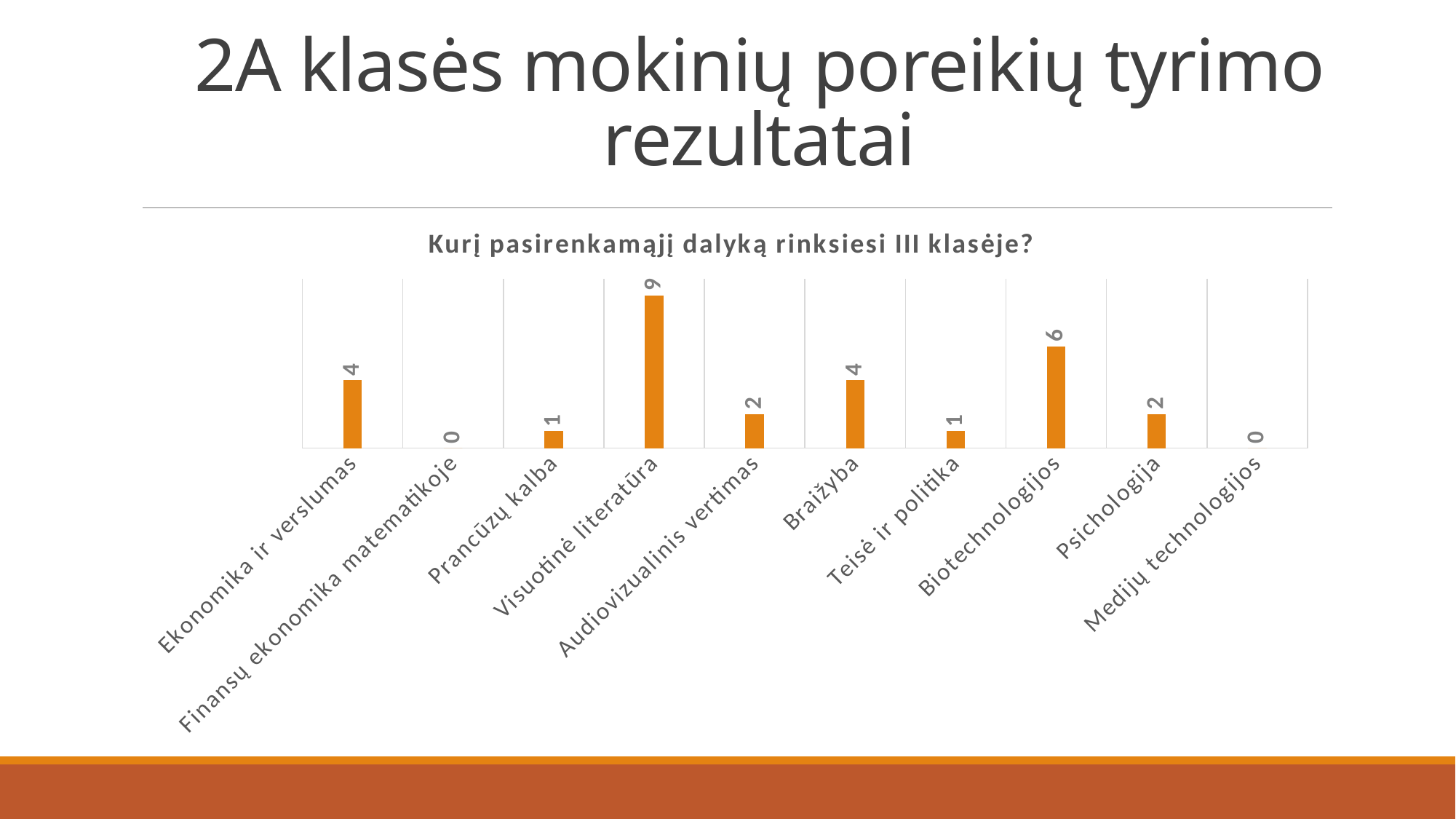
What is the difference between the values for Visuotinė literatūra and Biotechnologijos? 3 What is the value for Biotechnologijos? 6 What is the value for Visuotinė literatūra? 9 Which category has the highest value? Visuotinė literatūra How many categories are shown on the x axis? 10 What is the title of the chart? Kurį pasirenkamąjį dalyką rinksiesi III klasėje? What kind of chart is shown on the slide? Bar chart How many categories have a value of 0? 2 Which is larger, the value for Braižyba or the value for Audiovizualinis vertimas? Braižyba What is the value for Teisė ir politika? 1 What is the value for Psichologija? 2 What is the value for Ekonomika ir verslumas? 4